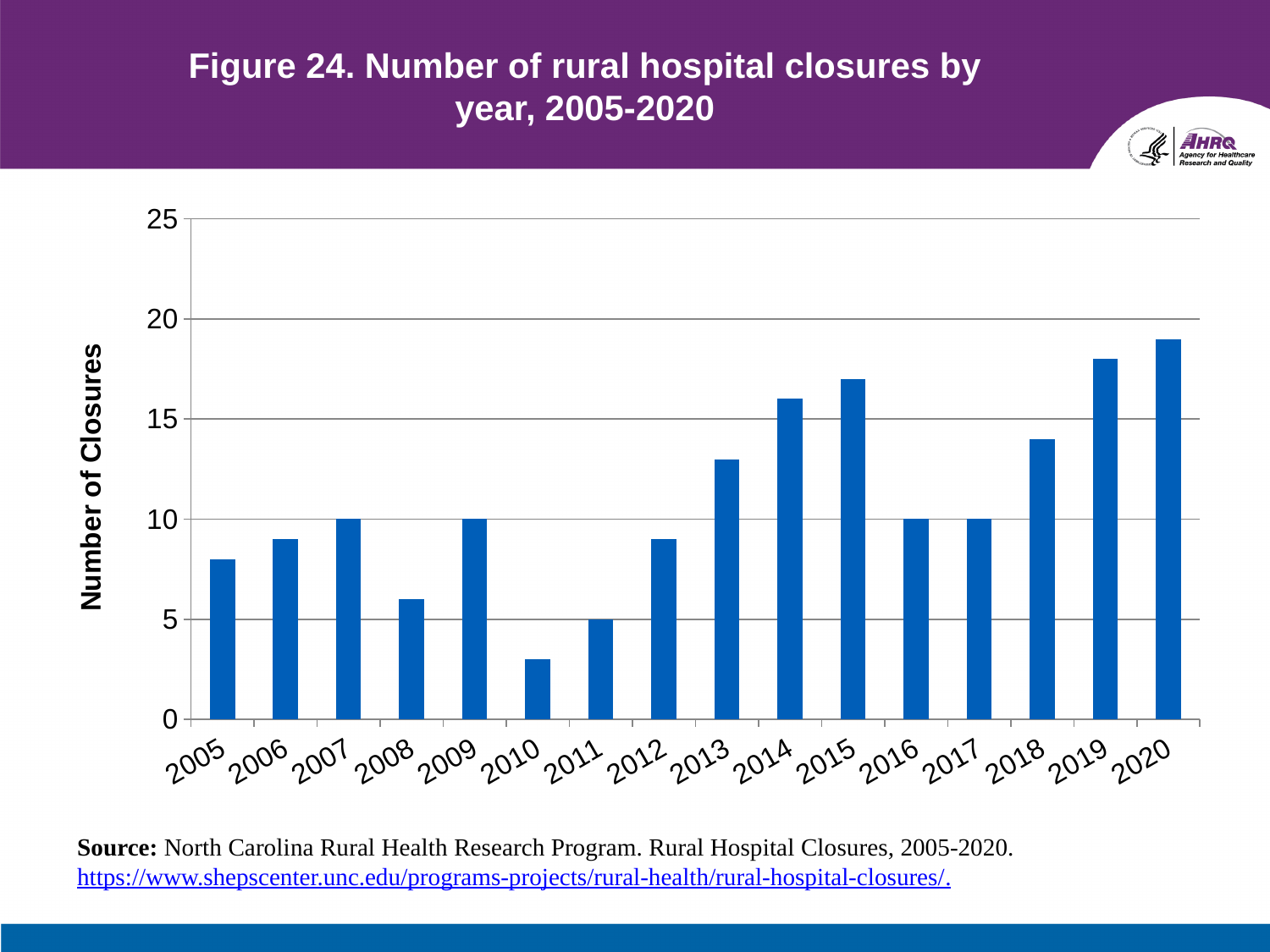
Do the number of closures rise or fall from 2010 to 2015? rise What is the number of closures in 2011? 5 What is the number of closures in 2007? 10 How many years are plotted on the x axis? 16 What type of chart is shown on the slide? bar chart Which year has the highest number of rural hospital closures? 2020 Is the number of closures in 2008 greater or less than 10? less What is the number of closures in 2016? 10 Is the number of closures in 2014 greater or less than 15? greater What is the label of the y axis? Number of Closures Which year has the lowest number of rural hospital closures? 2010 Which year had more closures, 2015 or 2018? 2015